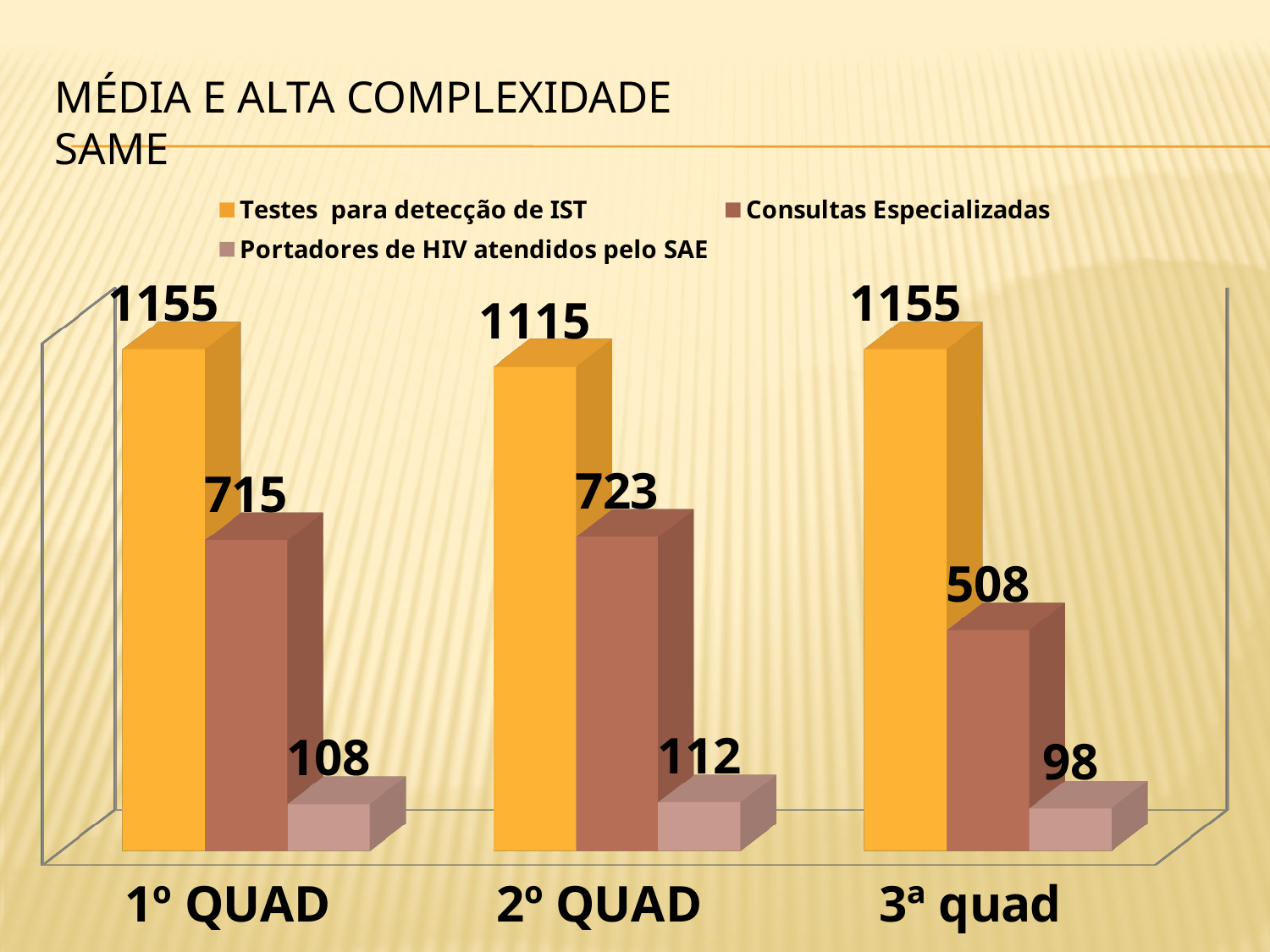
Which series is shown in yellow/orange in the legend? Testes para detecção de IST What kind of chart is shown on the slide? Bar chart In which period is the value for Portadores de HIV atendidos pelo SAE highest? 2º QUAD What is the difference between Consultas Especializadas in 1º QUAD and in 3ª quad? 207 What is the value for Portadores de HIV atendidos pelo SAE in 3ª quad? 98 Which is larger: Portadores de HIV atendidos pelo SAE in 1º QUAD or in 2º QUAD? 2º QUAD What is the value for Testes para detecção de IST in 2º QUAD? 1115 In which period is the value for Consultas Especializadas lowest? 3ª quad How many categories are shown on the x axis? 3 What is the value for Consultas Especializadas in 2º QUAD? 723 What is the value for Testes para detecção de IST in 1º QUAD? 1155 How many series does the legend list? 3